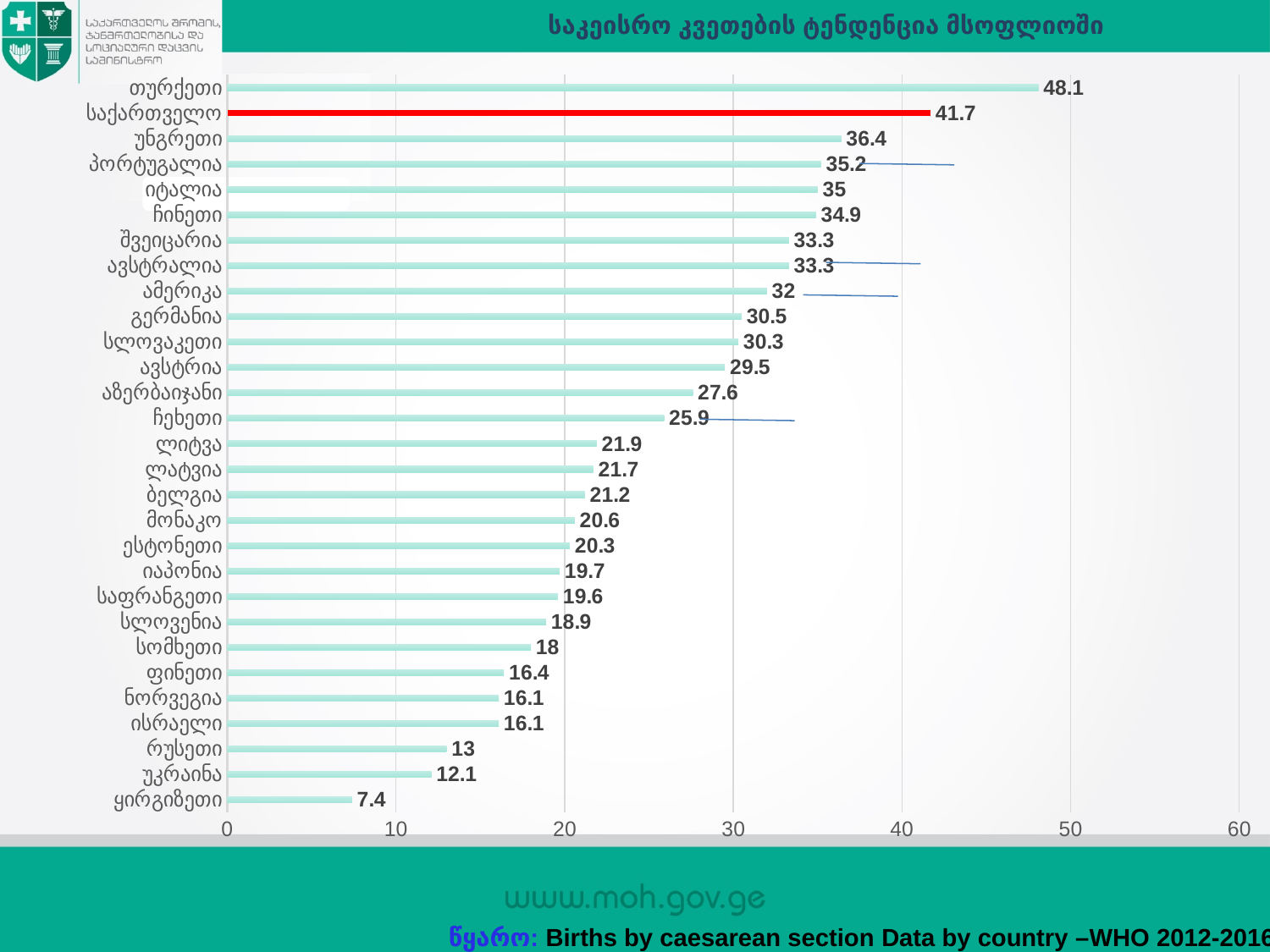
What is the difference between the values for თურქეთი and საქართველო? 6.4 What is the value for საქართველო? 41.7 Which has a larger value, უნგრეთი or გერმანია? უნგრეთი What kind of chart is shown on the slide? bar chart What is the value for თურქეთი? 48.1 Which bar is highlighted in red? საქართველო Which country has the highest value? თურქეთი How many countries are shown in the chart? 29 Is the value for ჩეხეთი greater or less than 30? less What is the value for აზერბაიჯანი? 27.6 What is the value for ყირგიზეთი? 7.4 Which country has the lowest value? ყირგიზეთი